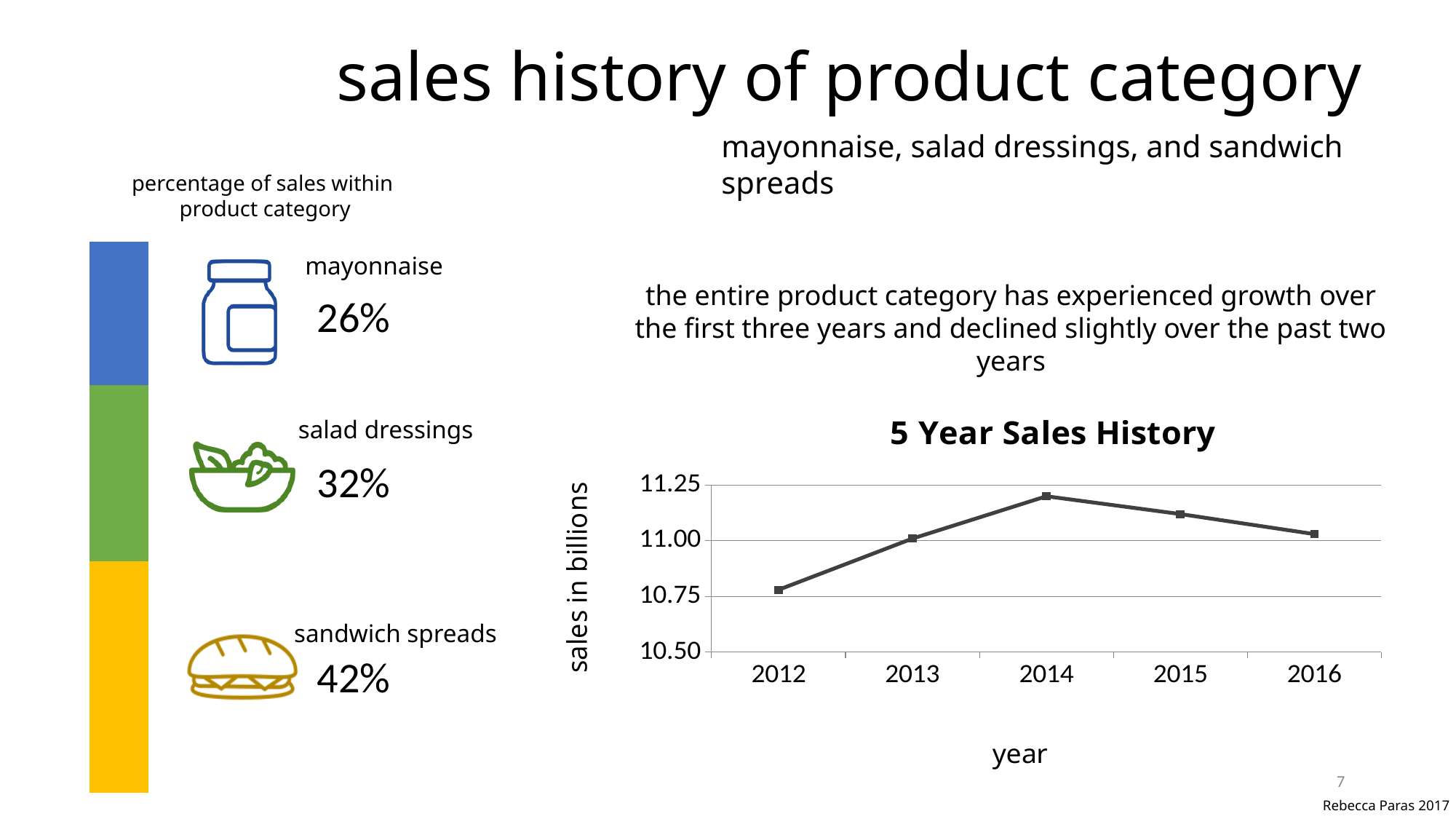
In the 5 Year Sales History chart, which year has the lowest sales? 2012 How many years are plotted in the 5 Year Sales History chart? 5 In the 5 Year Sales History chart, which year has larger sales, 2012 or 2014? 2014 What is the y-axis label of the 5 Year Sales History chart? sales in billions In the 5 Year Sales History chart, is the value for 2012 greater or less than 11.00? less In the 5 Year Sales History chart, which year has the highest sales? 2014 In the 5 Year Sales History chart, how do sales change from 2014 to 2016? they fall In the percentage of sales within product category chart on the left, what is the share for salad dressings? 32% What kind of chart is the 5 Year Sales History chart? line chart In the 5 Year Sales History chart, is the value for 2014 greater or less than 11.00? greater In the percentage of sales within product category chart on the left, which product has the largest share? sandwich spreads In the 5 Year Sales History chart, is the value for 2015 greater or less than 11.00? greater